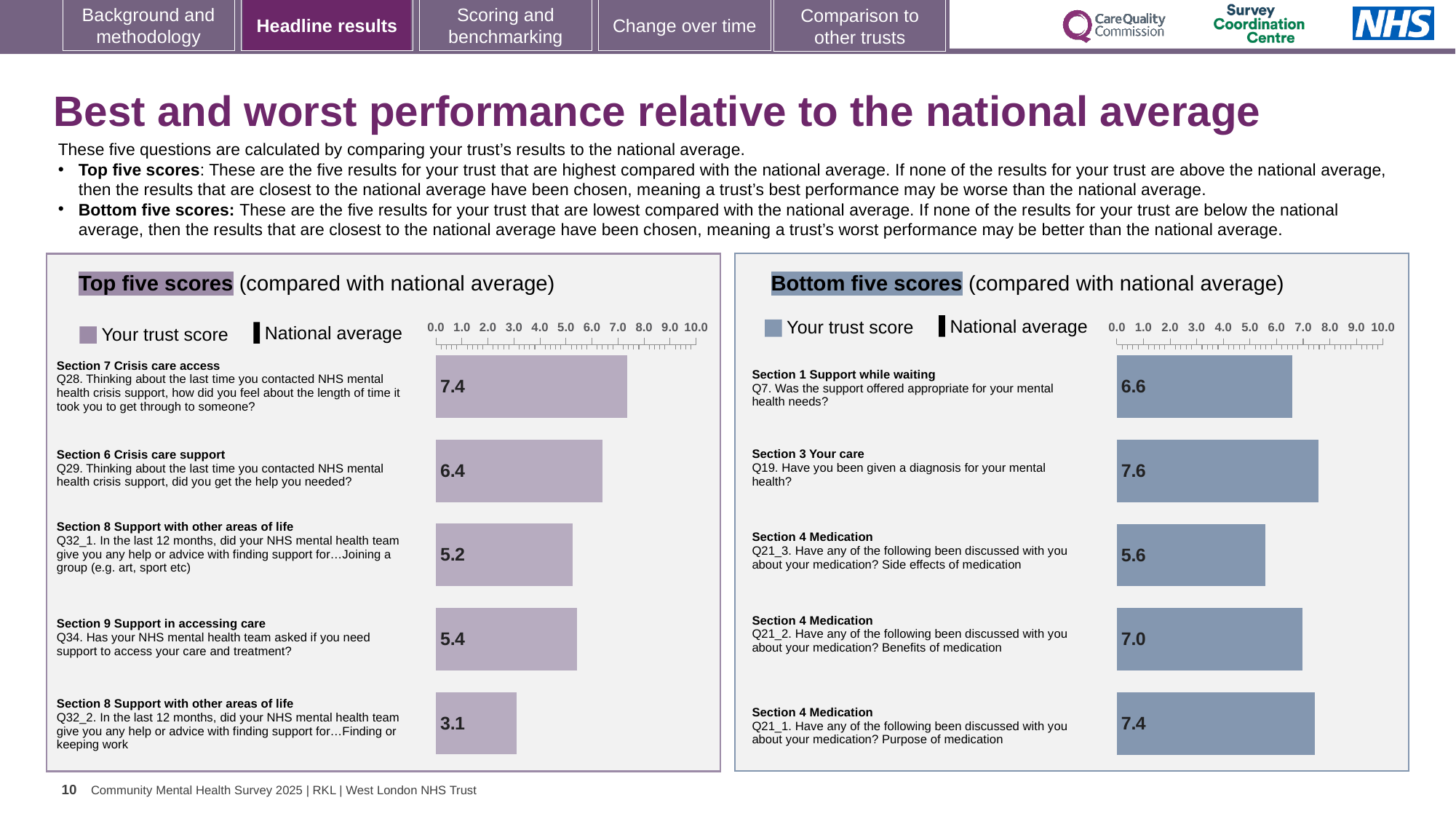
What kind of chart is the Bottom five scores chart? Bar chart In the Top five scores chart, which has the larger trust score, Q32_1 or Q34? Q34 In the Top five scores chart, what is the difference between the trust scores for Q28 and Q29? 1.0 In the Bottom five scores chart, which question has the highest trust score? Q19 How many entries does the legend of the Top five scores chart list? 2 In the Top five scores chart, what is the trust score for Q28 (Section 7 Crisis care access)? 7.4 In the Bottom five scores chart, what is the difference between the trust scores for Q21_1 and Q21_2? 0.4 In the Bottom five scores chart, what is the trust score for Q19 (Section 3 Your care)? 7.6 In the Top five scores chart, what is the trust score for Q32_2 (finding or keeping work)? 3.1 In the Top five scores chart, which question has the lowest trust score? Q32_2 In the Bottom five scores chart, what is the trust score for Q21_3 (side effects of medication)? 5.6 How many bars are plotted in the Top five scores chart? 5